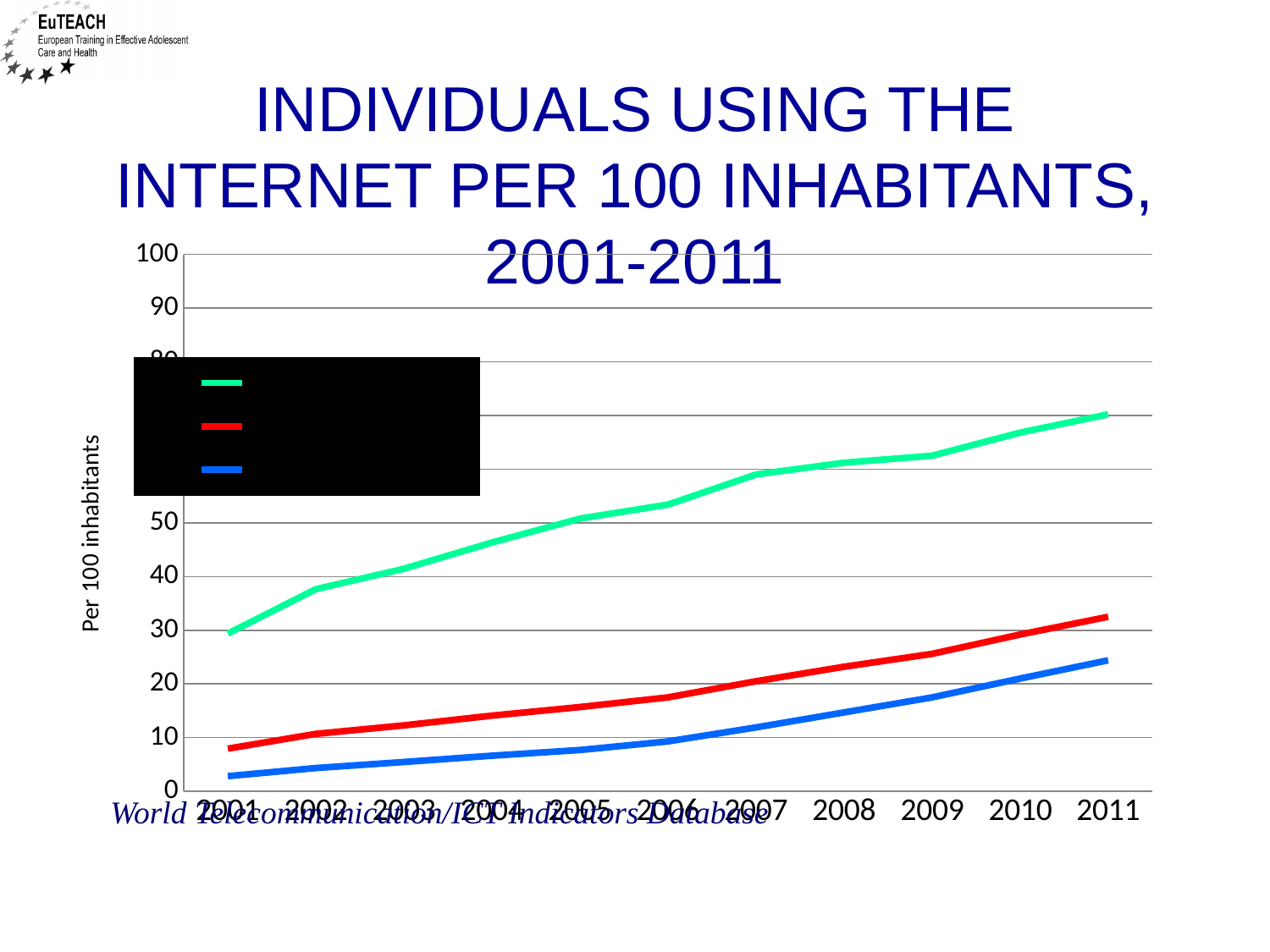
Does the green line rise or fall from 2001 to 2011? rise In which year does the green line reach its highest value? 2011 In 2011, which line has the larger value, the green line or the red line? green line In which year is the red line at its lowest value? 2001 Is the value of the green line in 2011 greater or less than 60? greater Is the value of the blue line in 2011 greater or less than 30? less What kind of chart is shown on the slide? line chart How many years are plotted along the x axis? 11 Does the blue line rise or fall across the years shown? rise What is the label on the vertical axis of the chart? Per 100 inhabitants Is the value of the blue line in 2001 greater or less than 10? less How many series does the legend list? 3